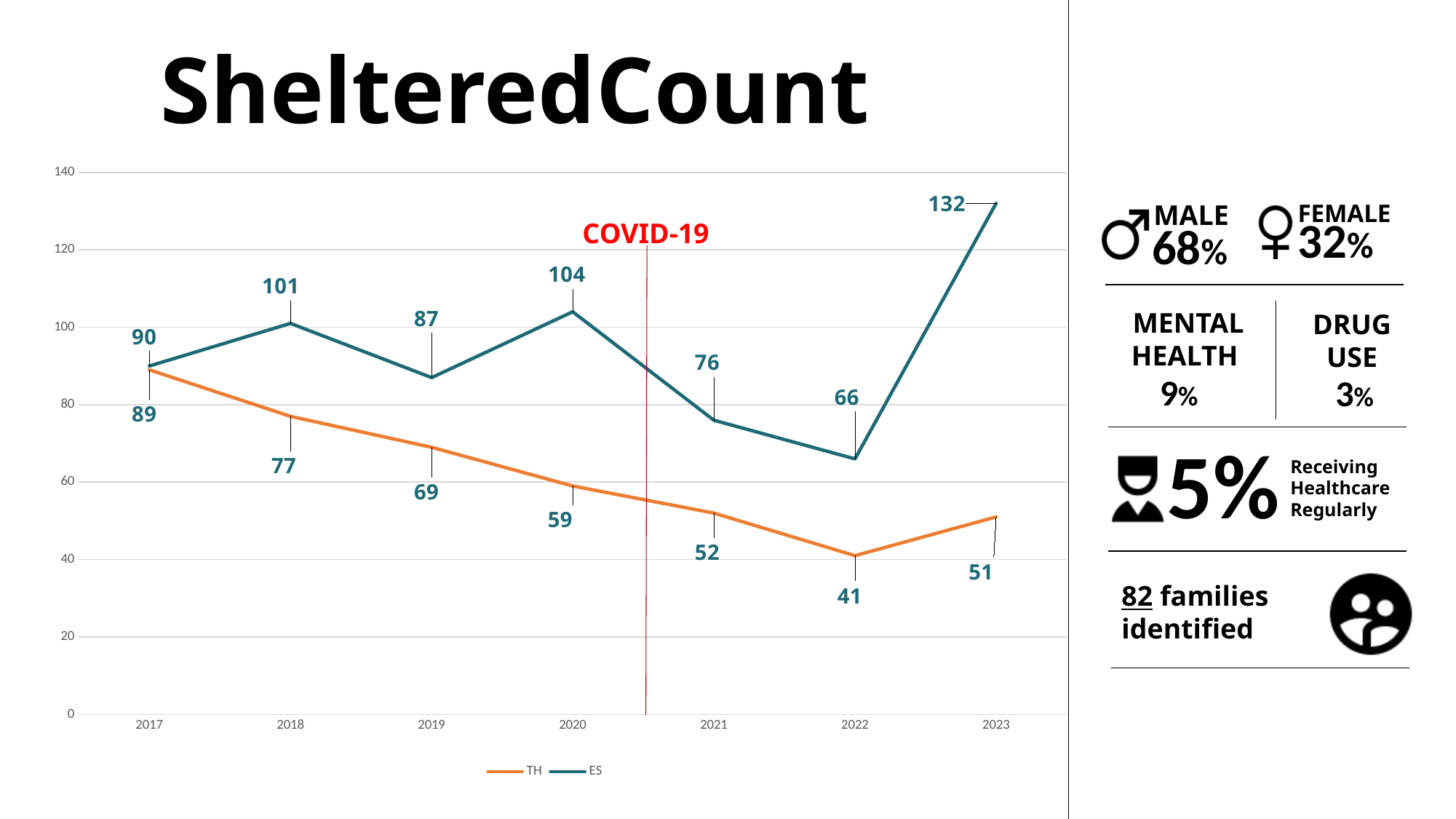
What type of chart is shown on the slide? line chart Which series has the larger value in 2021, TH or ES? ES What is the difference between the ES values for 2022 and 2023? 66 In which year is the ES value highest? 2023 How many series does the legend list? 2 What is the ES value for 2020? 104 In which year is the TH value lowest? 2022 What is the title of the chart? ShelteredCount What is the difference between the ES and TH values in 2023? 81 How many years are plotted on the x axis? 7 What is the TH value for 2022? 41 Does the TH series rise or fall from 2017 to 2022? fall